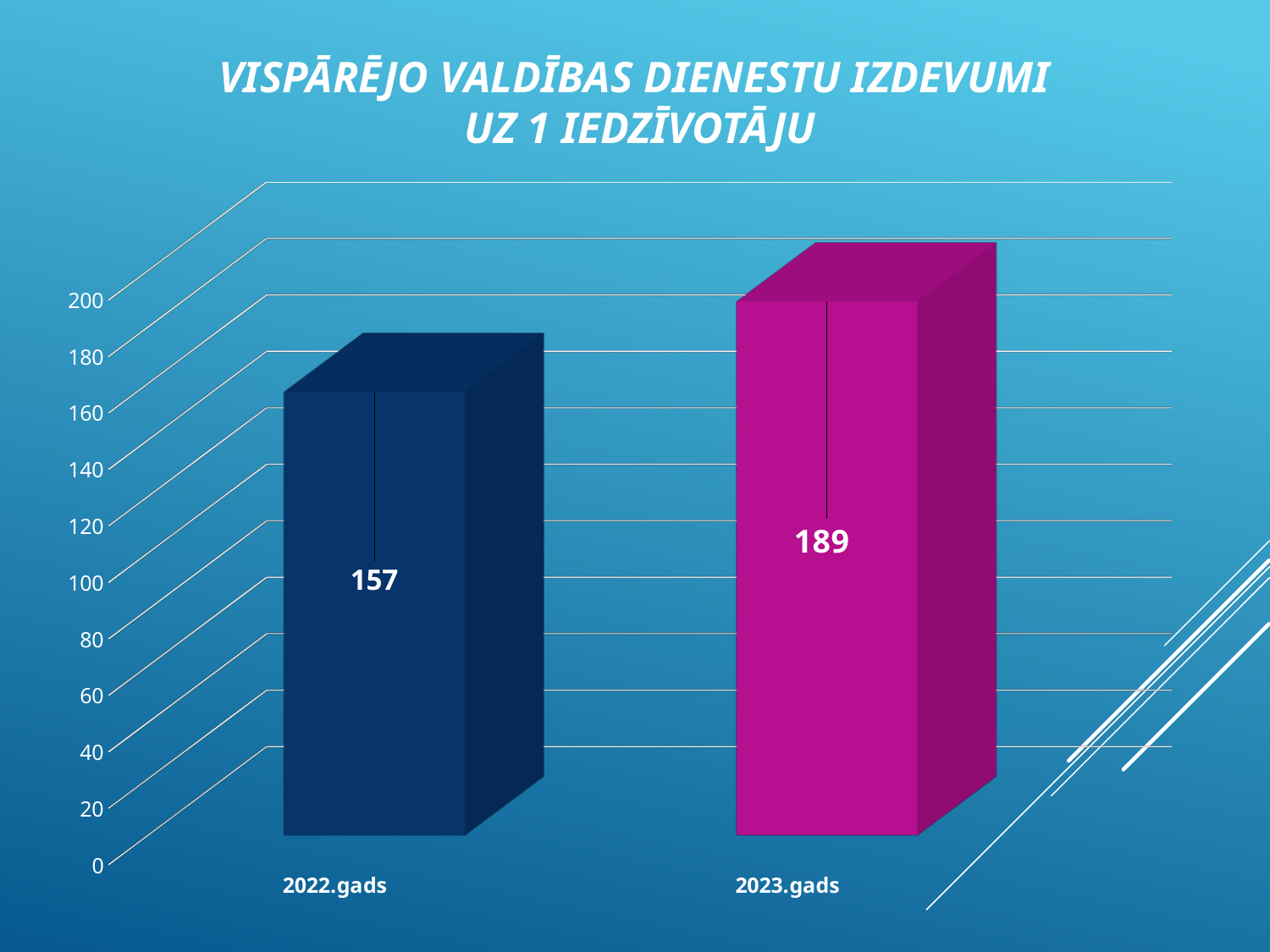
What is the title of the chart? VISPĀRĒJO VALDĪBAS DIENESTU IZDEVUMI UZ 1 IEDZĪVOTĀJU Which category has the lowest value? 2022.gads Do the values rise or fall from 2022.gads to 2023.gads? rise What is the difference between the values for 2023.gads and 2022.gads? 32 What kind of chart is shown on the slide? bar chart Which is larger, the value for 2022.gads or the value for 2023.gads? 2023.gads How many categories are shown on the chart? 2 What is the value for 2023.gads? 189 Is the value for 2023.gads greater or less than 200? less What is the value for 2022.gads? 157 Which category has the highest value? 2023.gads Is the value for 2022.gads greater or less than 140? greater